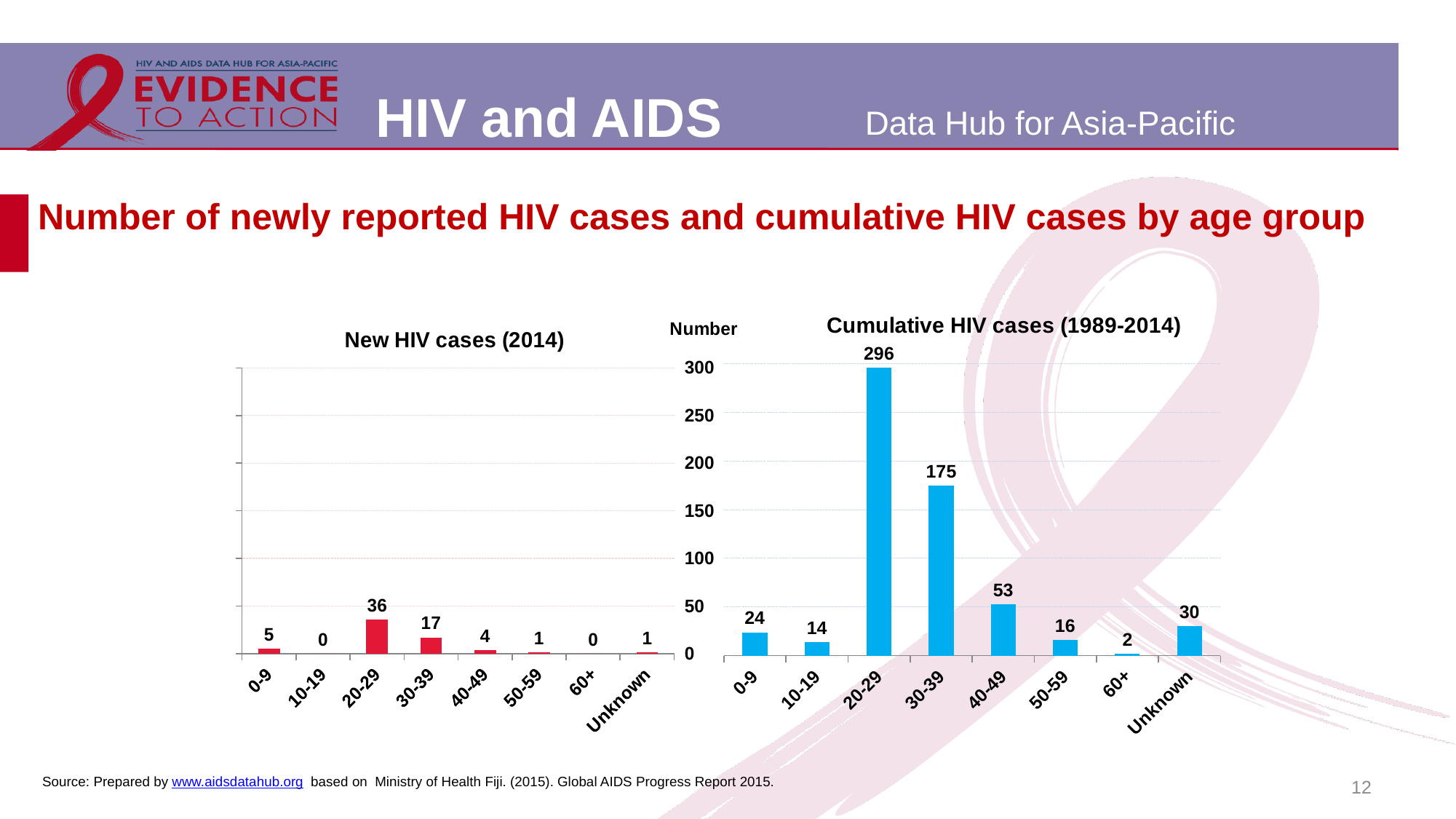
In the 'Cumulative HIV cases (1989-2014)' chart, what is the value for the 30-39 age group? 175 In the 'New HIV cases (2014)' chart, which age group has the highest value? 20-29 How many age group categories are shown in the 'New HIV cases (2014)' chart? 8 In the 'Cumulative HIV cases (1989-2014)' chart, is the value for 40-49 greater or less than 100? less What kind of chart is the 'Cumulative HIV cases (1989-2014)' chart? bar chart In the 'Cumulative HIV cases (1989-2014)' chart, what is the difference between the values for 20-29 and 30-39? 121 In the 'New HIV cases (2014)' chart, what is the difference between the values for 20-29 and 30-39? 19 In the 'Cumulative HIV cases (1989-2014)' chart, which age group has the highest value? 20-29 In the 'Cumulative HIV cases (1989-2014)' chart, which is larger, the value for 0-9 or the value for Unknown? Unknown What is the label on the shared vertical axis between the two charts? Number In the 'Cumulative HIV cases (1989-2014)' chart, which age group has the lowest value? 60+ In the 'New HIV cases (2014)' chart, what is the value for the 20-29 age group? 36